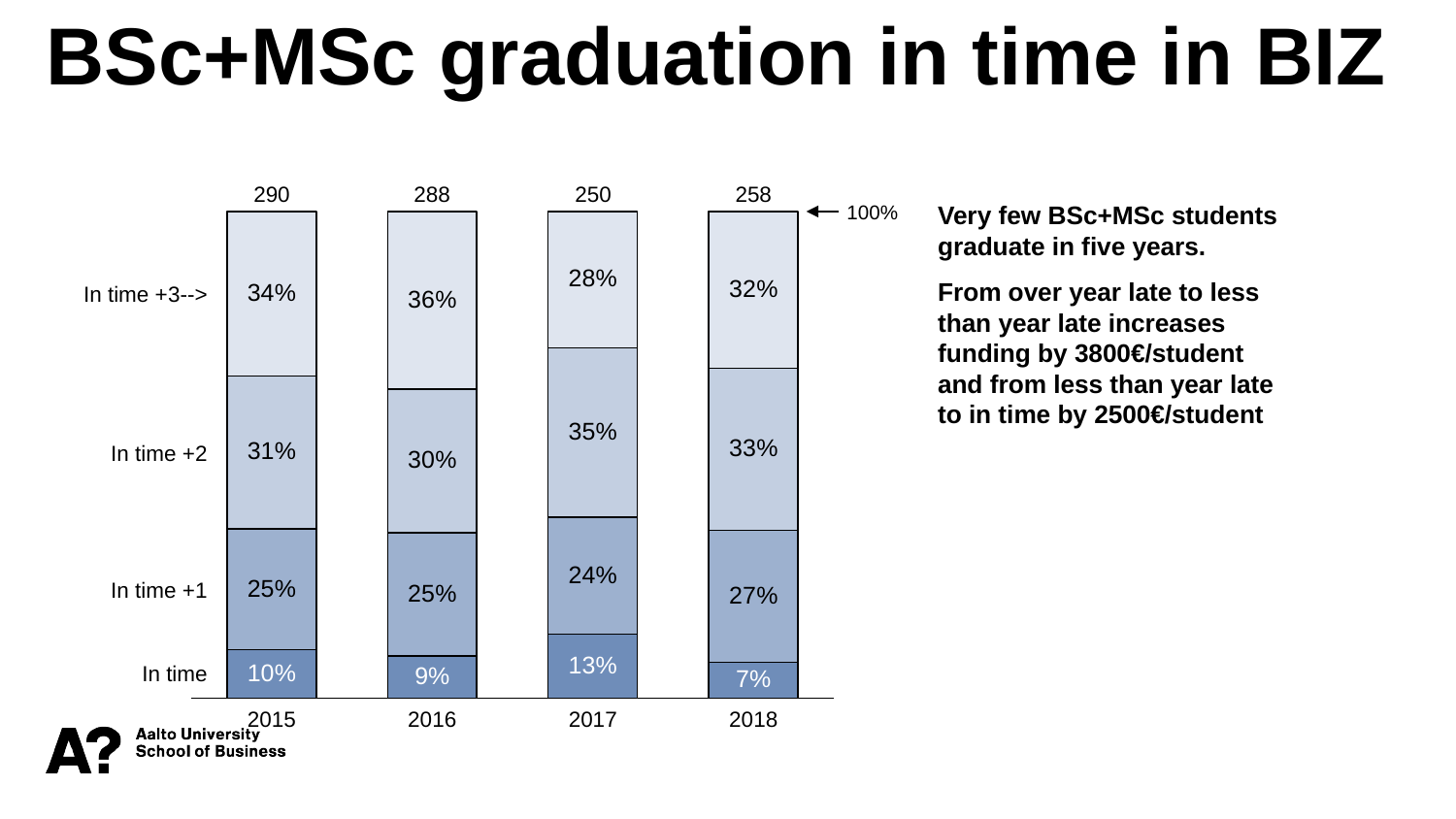
What is the difference between the 'In time +1' percentages for 2018 and 2017? 3% How many segments make up each stacked bar? 4 What is the title of the slide containing the chart? BSc+MSc graduation in time in BIZ Which year has the highest 'In time +2' percentage? 2017 Which year has the lowest 'In time' percentage? 2018 Is the 'In time +3-->' share larger in 2015 or in 2017? 2015 What is the 'In time +3-->' share for 2016? 36% What percentage of students graduated in time in 2017? 13% How many years are shown on the x axis? 4 What number is printed above the 2015 bar? 290 What kind of chart is shown on the slide? Stacked bar chart What is the combined percentage of 'In time' and 'In time +1' for 2016? 34%